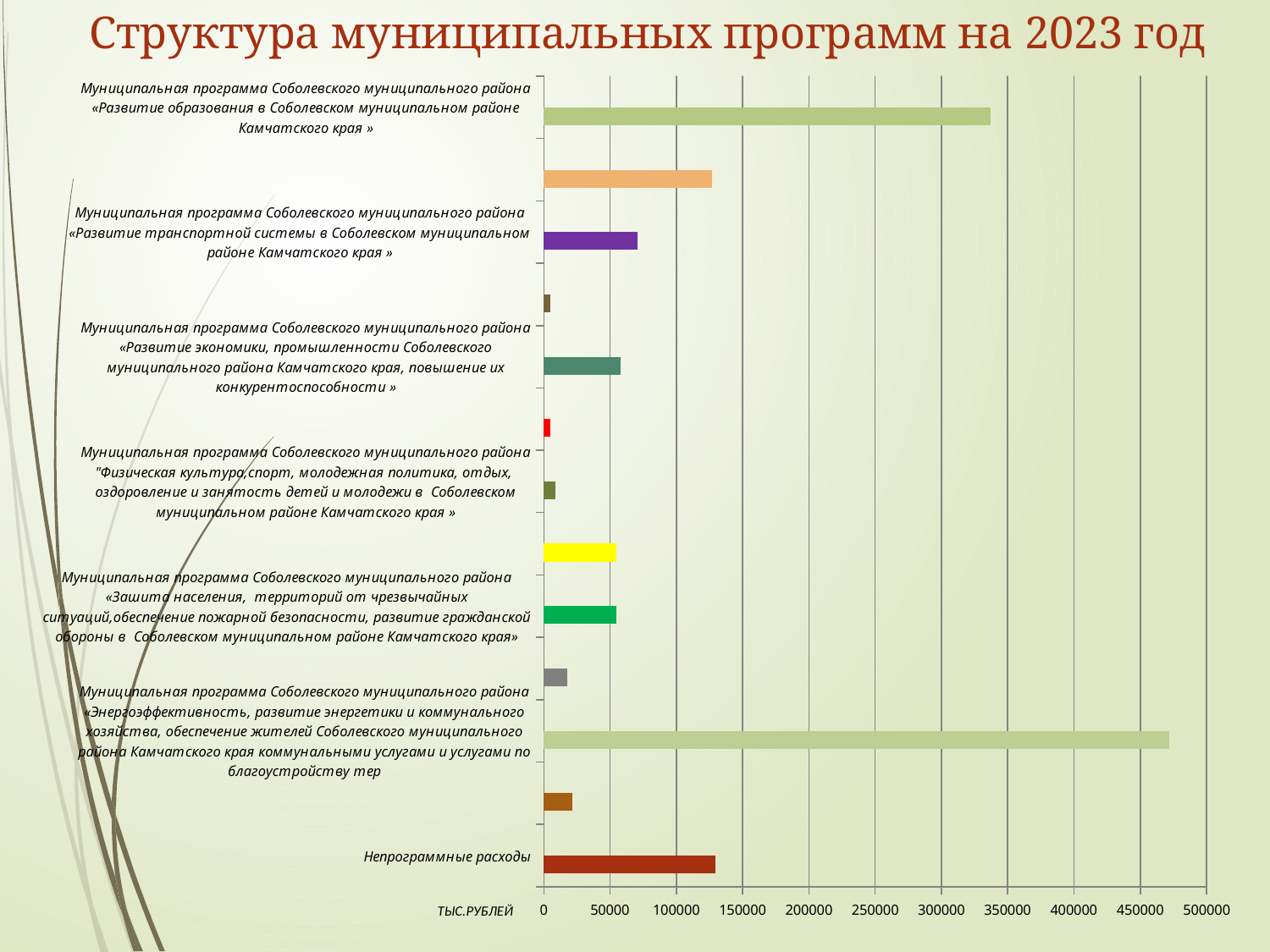
Is the value for the programme «Развитие образования в Соболевском муниципальном районе Камчатского края» greater or less than 300000? greater Which labelled programme has the longest bar in the chart? «Энергоэффективность, развитие энергетики и коммунального хозяйства...» Is the value for the programme «Энергоэффективность, развитие энергетики и коммунального хозяйства...» greater or less than 450000? greater Is the value for the programme "Физическая культура, спорт, молодежная политика, отдых, оздоровление и занятость детей и молодежи" greater or less than 50000? less What is the title of the slide chart? Структура муниципальных программ на 2023 год What kind of chart is shown on the slide? bar chart Which is larger: the value for «Энергоэффективность, развитие энергетики и коммунального хозяйства...» or the value for «Развитие образования...»? «Энергоэффективность, развитие энергетики и коммунального хозяйства...» Which is larger: the value for «Развитие образования...» or the value for Непрограммные расходы? «Развитие образования...» How many bars are plotted in the chart? 13 What unit is indicated on the horizontal axis of the chart? ТЫС.РУБЛЕЙ